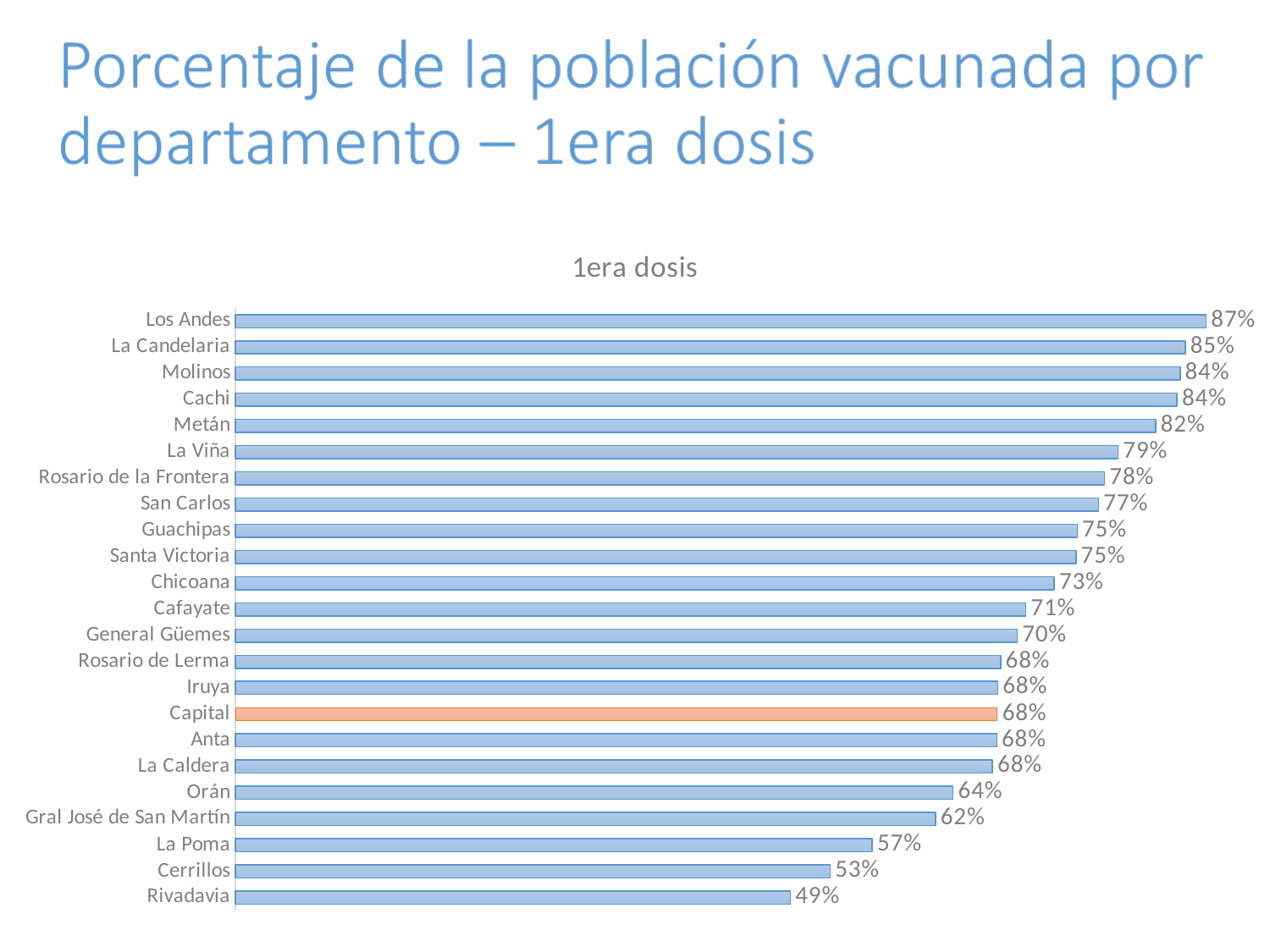
How many departments are shown in the chart? 23 What is the difference between the values for Metán and La Poma? 25% What is the difference between the values for Los Andes and Rivadavia? 38% What is the value for Capital? 68% Which is larger, the value for Cafayate or the value for Orán? Cafayate What kind of chart is this? Bar chart Which department has the highest value? Los Andes Which department has the lowest value? Rivadavia Which department's bar is shown in a different colour (orange) from the others? Capital What is the value for Cerrillos? 53% What is the value for Los Andes? 87% What is the title of the chart? 1era dosis